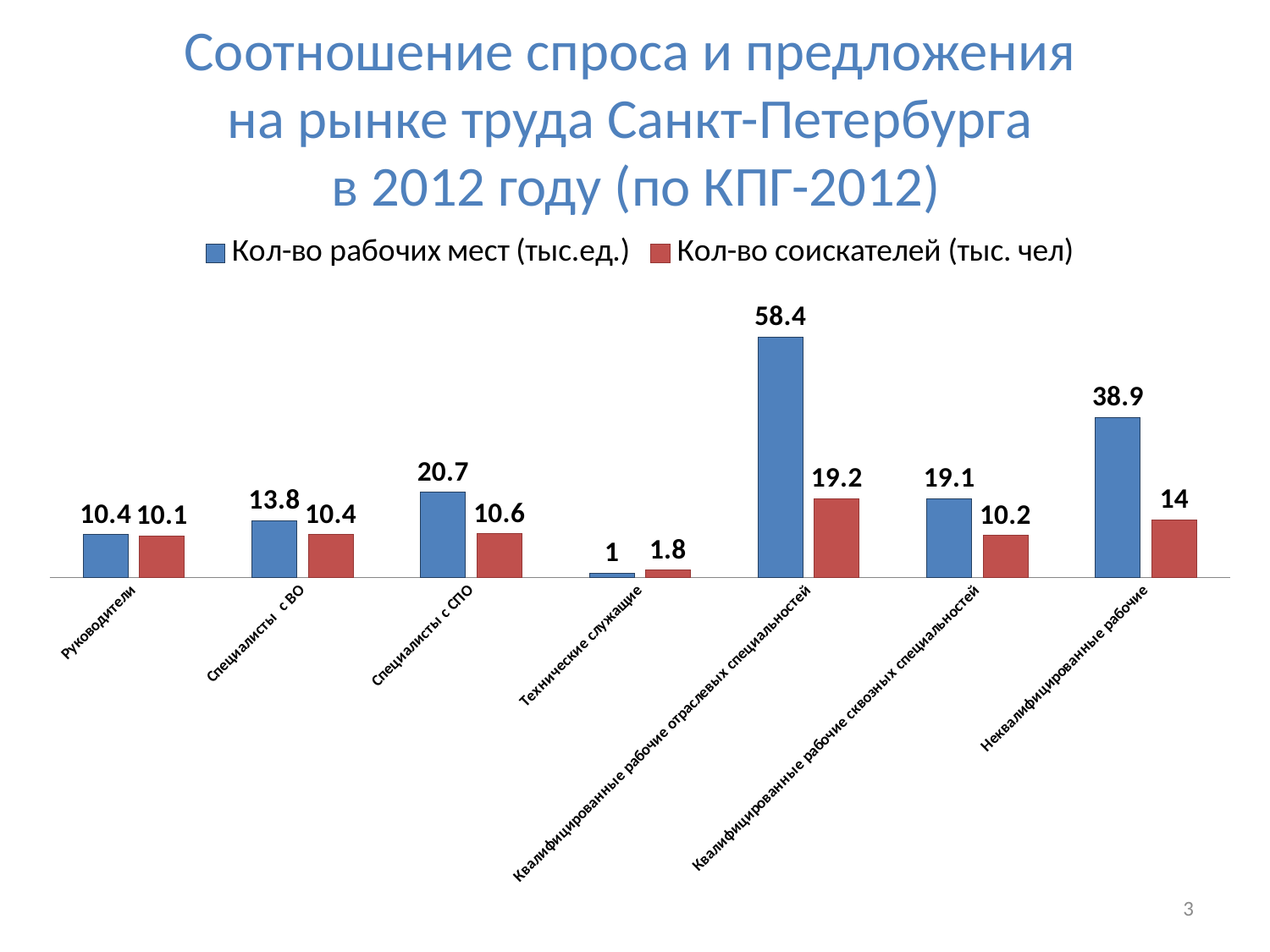
What is the difference between Кол-во рабочих мест (тыс.ед.) and Кол-во соискателей (тыс. чел) for Неквалифицированные рабочие? 24.9 How many categories are shown on the x axis? 7 For Технические служащие, which is larger: Кол-во рабочих мест (тыс.ед.) or Кол-во соискателей (тыс. чел)? Кол-во соискателей (тыс. чел) Which category has the lowest value for Кол-во соискателей (тыс. чел)? Технические служащие What is the difference between Кол-во рабочих мест (тыс.ед.) and Кол-во соискателей (тыс. чел) for Квалифицированные рабочие отраслевых специальностей? 39.2 For Специалисты с ВО, which is larger: Кол-во рабочих мест (тыс.ед.) or Кол-во соискателей (тыс. чел)? Кол-во рабочих мест (тыс.ед.) What is the value of Кол-во соискателей (тыс. чел) for Неквалифицированные рабочие? 14 What kind of chart is shown on the slide? Bar chart What is the value of Кол-во соискателей (тыс. чел) for Специалисты с СПО? 10.6 What is the value of Кол-во рабочих мест (тыс.ед.) for Руководители? 10.4 Which category has the highest value for Кол-во рабочих мест (тыс.ед.)? Квалифицированные рабочие отраслевых специальностей How many series does the legend list? 2